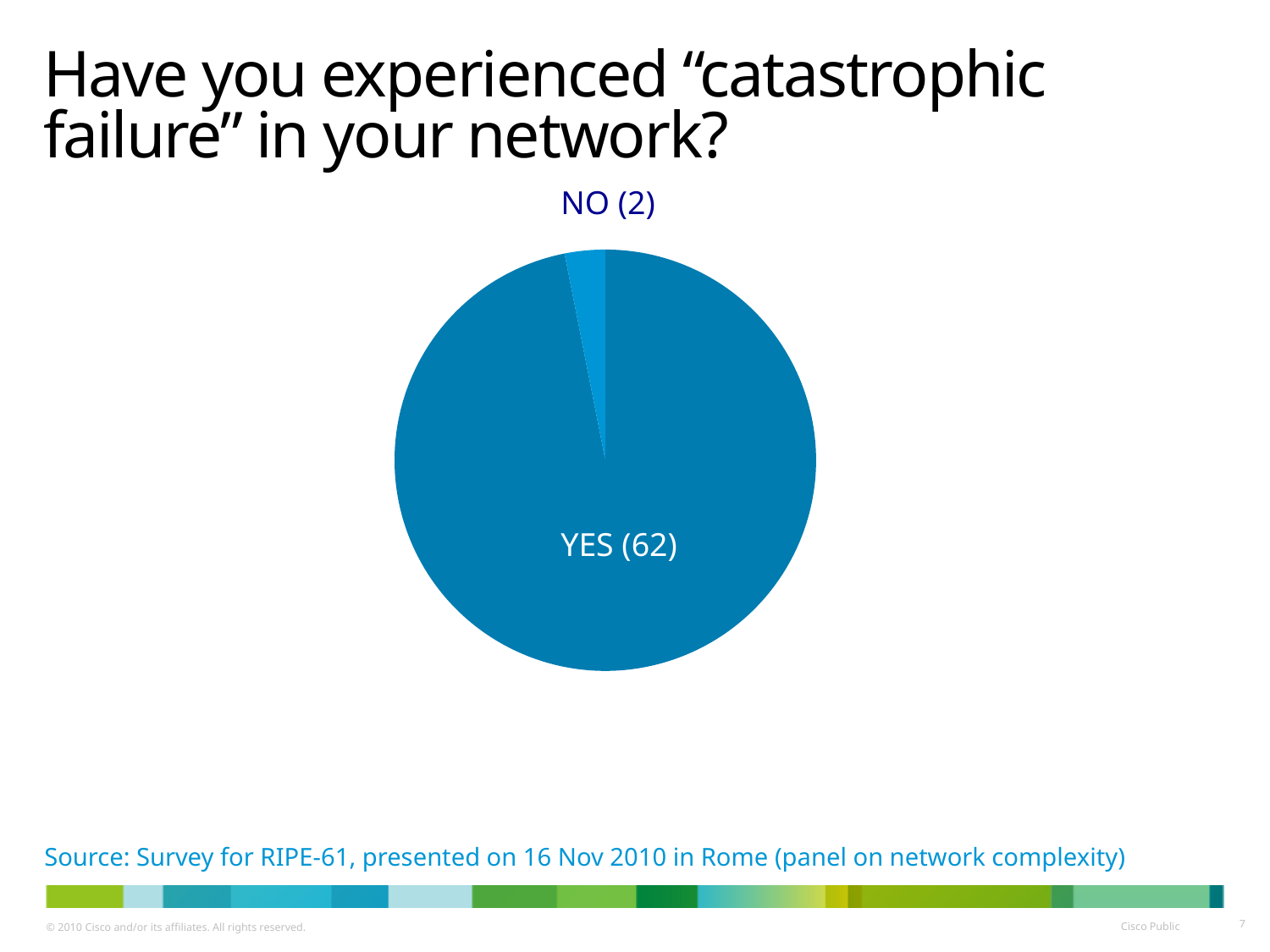
Which is larger, the YES count or the NO count? YES What kind of chart is shown on the slide? pie chart What is the question asked in the slide title? Have you experienced "catastrophic failure" in your network? Which response has the smallest slice of the pie? NO What is the source of the survey data shown in the chart? Survey for RIPE-61, presented on 16 Nov 2010 in Rome (panel on network complexity) How many respondents answered YES? 62 What is the total number of responses shown in the pie chart? 64 Which response has the largest slice of the pie? YES What is the difference between the number of YES and NO responses? 60 How many slices does the pie chart have? 2 How many respondents answered NO? 2